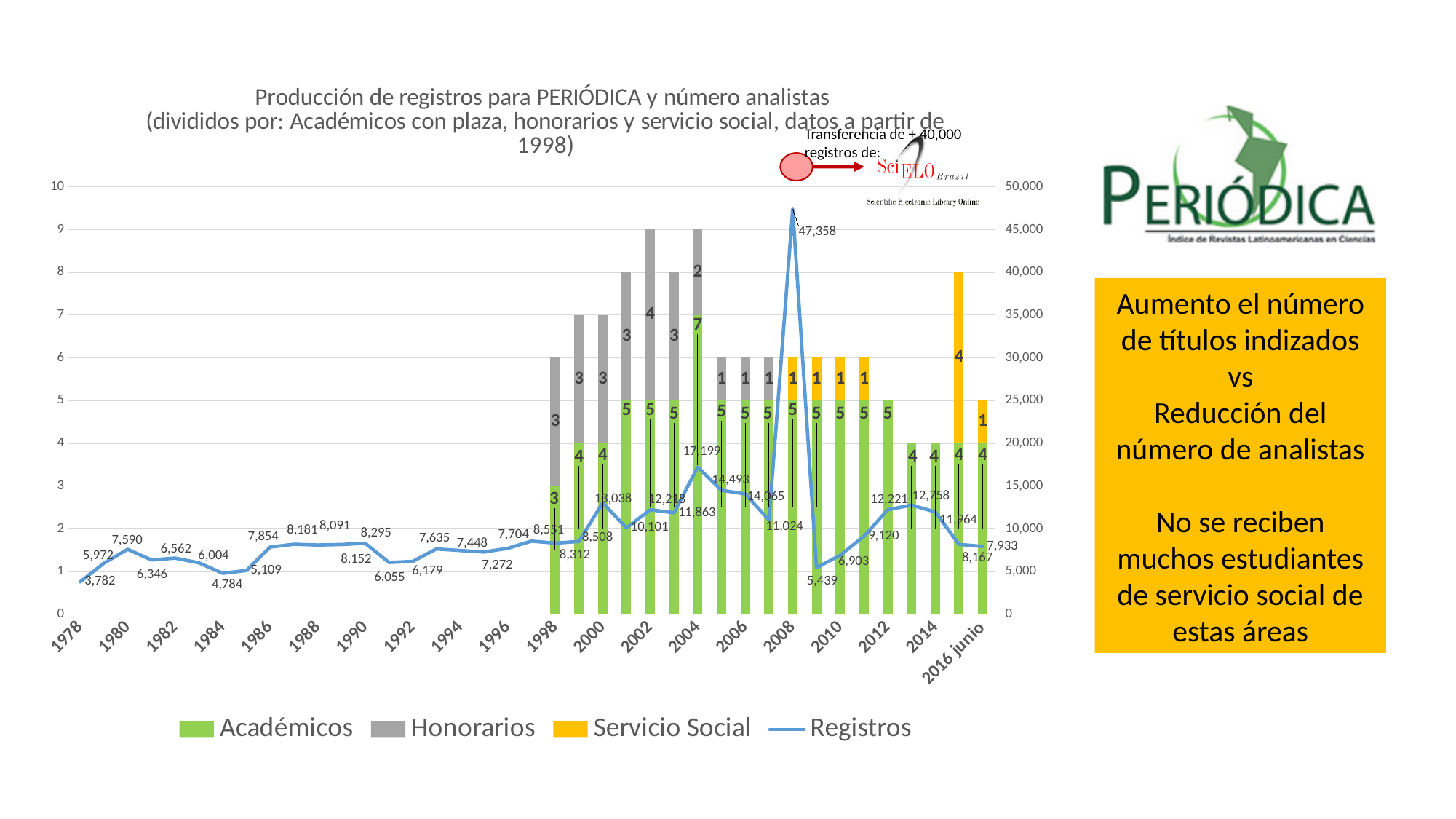
What is the value of Registros in 2008? 47,358 What is the difference between the Registros values for 2008 and 2010? 40,455 What colour represents the Honorarios series in the chart? Gray What is the value of Registros in 1978? 3,782 What is the total height of the stacked bar for 2004 (Académicos plus Honorarios)? 9 How many Académicos are shown for 2004? 7 What is the Servicio Social value for 2016 junio? 1 How many series does the chart legend list? 4 Which year has the larger Registros value, 1980 or 1990? 1990 In which year is the Registros value lowest? 1978 In which year does the Registros line reach its highest value? 2008 What kind of chart is shown on the slide? A combined bar and line chart (stacked bars with a line)